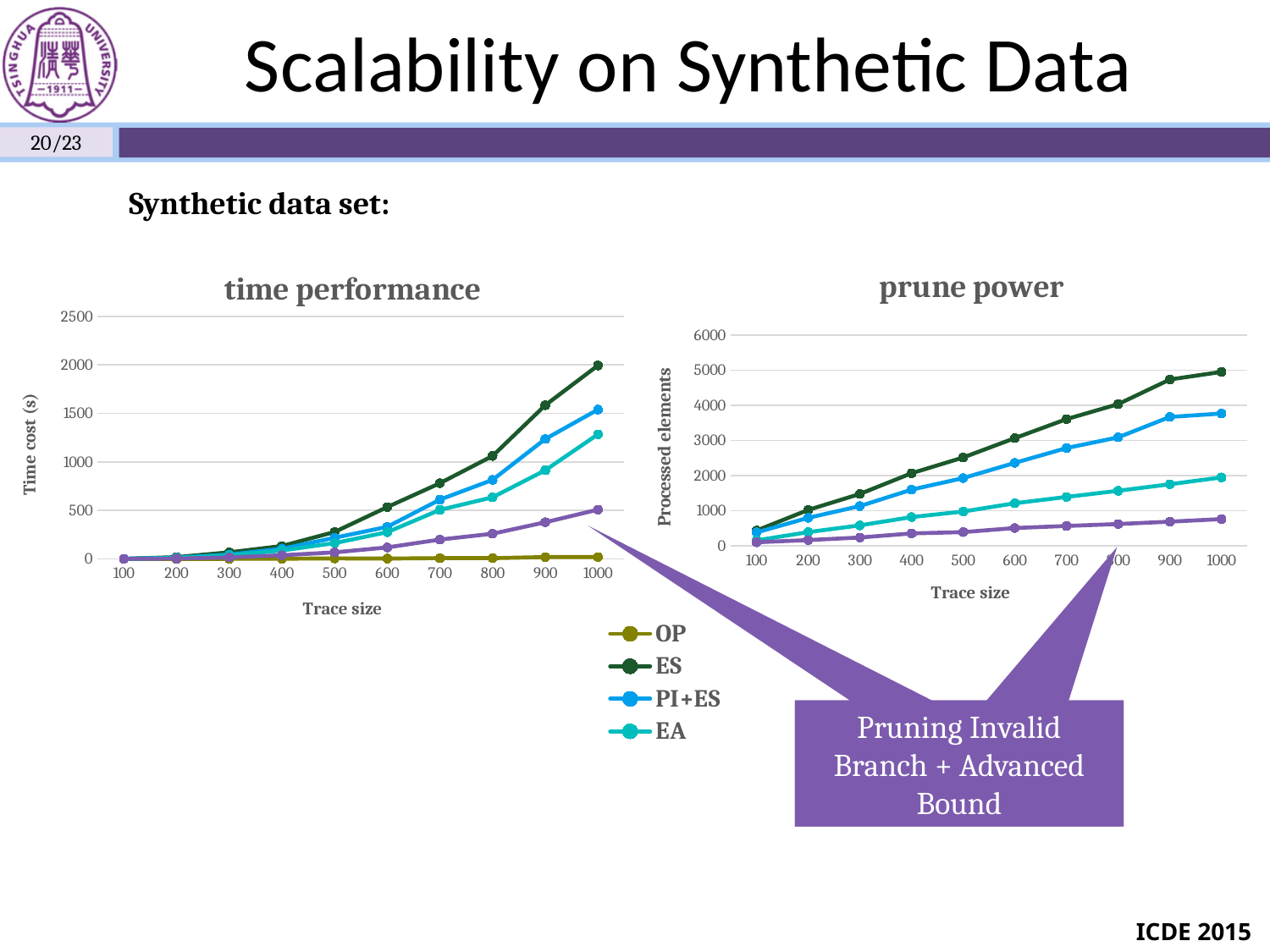
In the "prune power" chart, which series has more processed elements at trace size 1000, ES or EA? ES In the "prune power" chart, is the number of processed elements for PI+ES at trace size 1000 greater or less than 4000? less In the "time performance" chart, is the time cost for ES at trace size 700 greater or less than 500? greater What is the y-axis label of the "prune power" chart? Processed elements In the "prune power" chart, is the number of processed elements for ES at trace size 900 greater or less than 4000? greater In the "time performance" chart, which series has the lowest time cost across all trace sizes? OP What kind of chart is the "time performance" chart? line chart How many series does the legend below the "time performance" chart list? 4 In the "time performance" chart, which series has the highest time cost at trace size 1000? ES In the "prune power" chart, do the processed elements for ES rise or fall as trace size increases? rise How many trace size points are plotted along the x axis of the "prune power" chart? 10